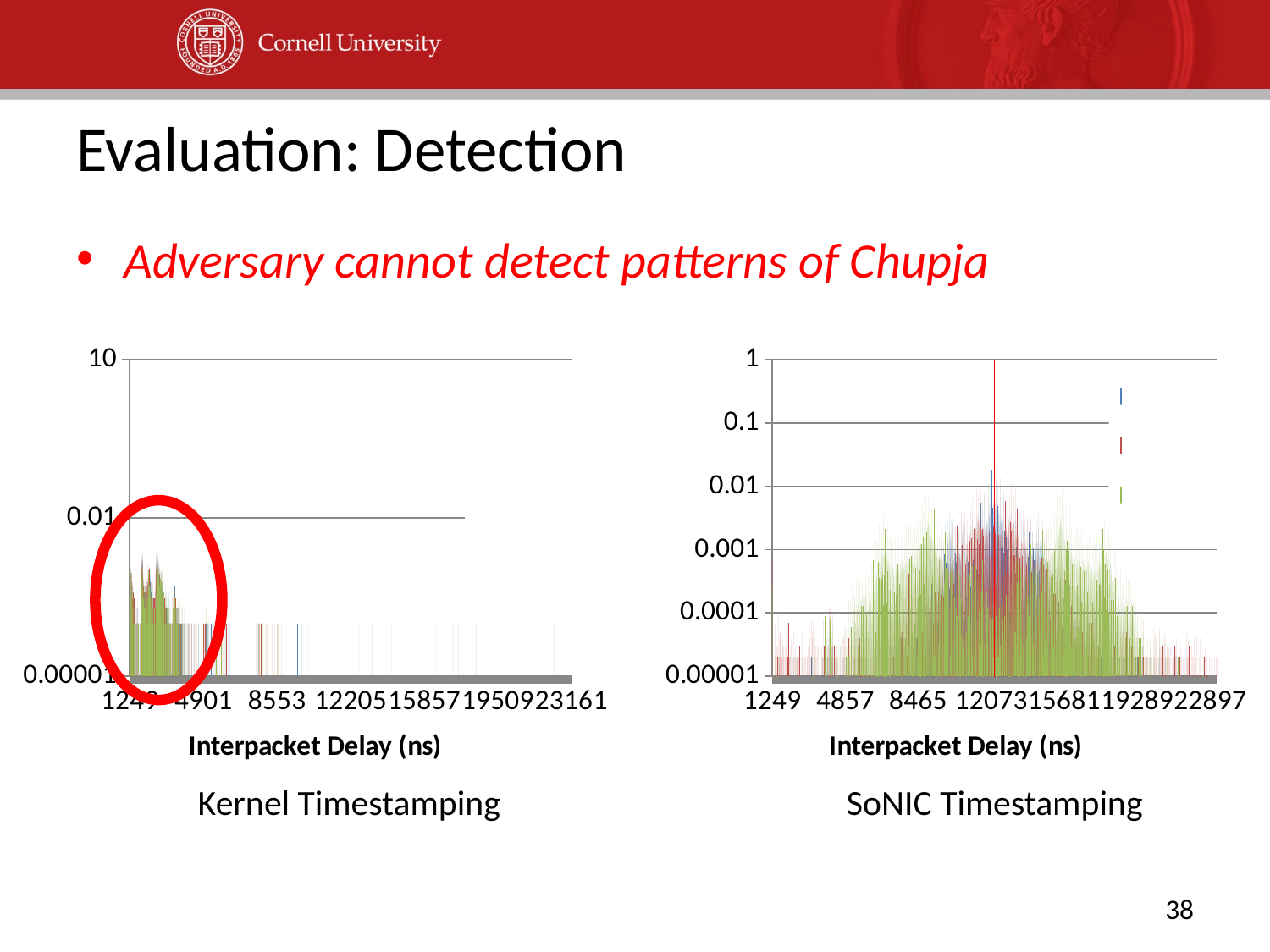
In the Kernel Timestamping chart, is the tallest spike greater or less than 0.01? greater What is the x-axis title of the Kernel Timestamping chart? Interpacket Delay (ns) What is the highest tick value shown on the y-axis of the SoNIC Timestamping chart? 1 What kind of chart is the SoNIC Timestamping chart on the right? bar chart In the SoNIC Timestamping chart, is the tallest spike greater or less than 0.1? greater What kind of chart is the Kernel Timestamping chart on the left? bar chart